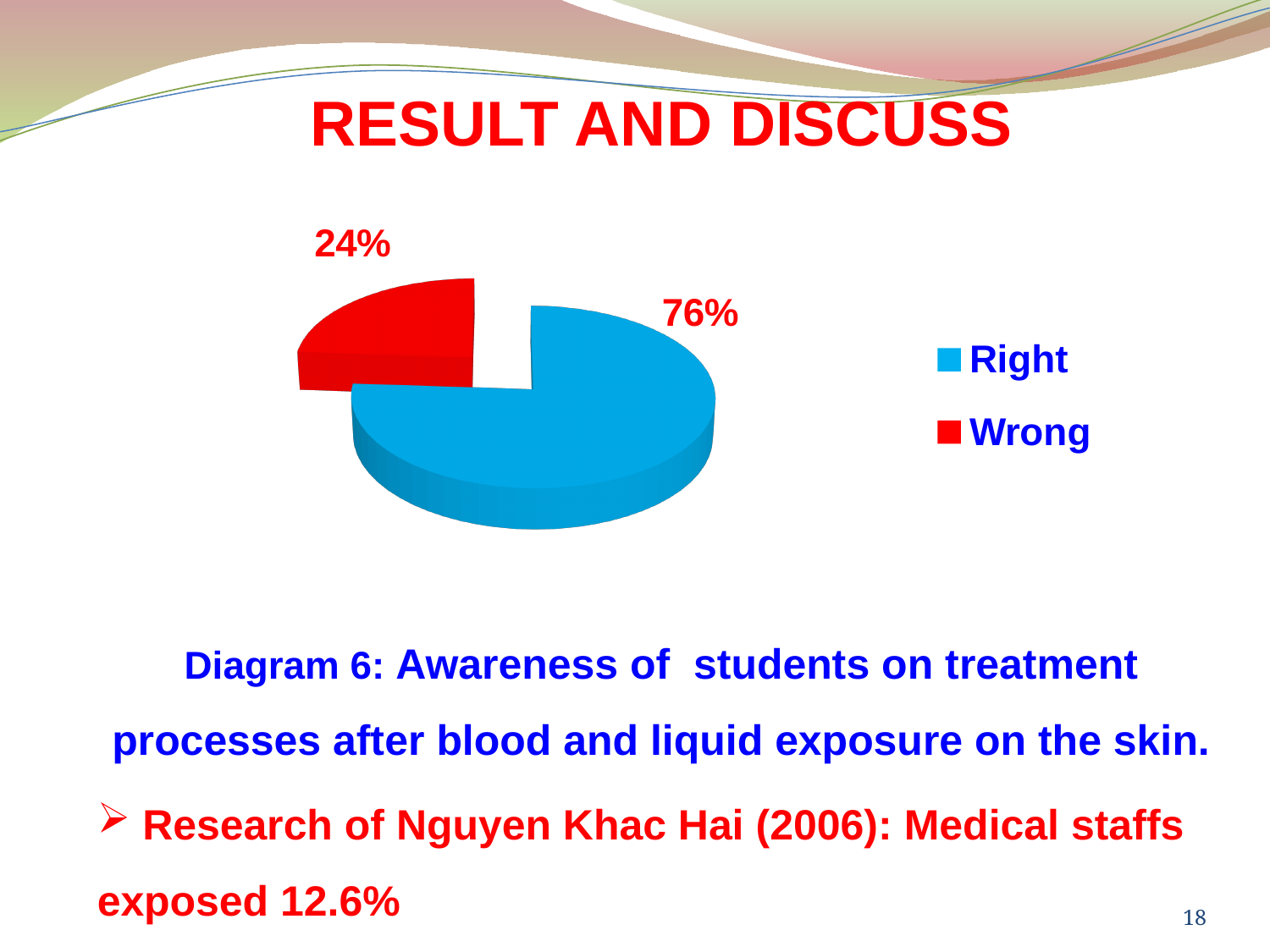
What kind of chart is shown on the slide? Pie chart What percentage of students answered Wrong? 24% What colour is the Right slice? Blue How many entries does the legend list? 2 What is the caption of the diagram shown on the slide? Diagram 6: Awareness of students on treatment processes after blood and liquid exposure on the skin. What percentage of students answered Right? 76% Which is larger, the share for Right or the share for Wrong? Right What share of the pie does the Wrong slice represent? 24% What is the difference in percentage points between Right and Wrong? 52 How many slices does the pie chart have? 2 Which category has the largest share of the pie? Right Which category has the smallest share of the pie? Wrong